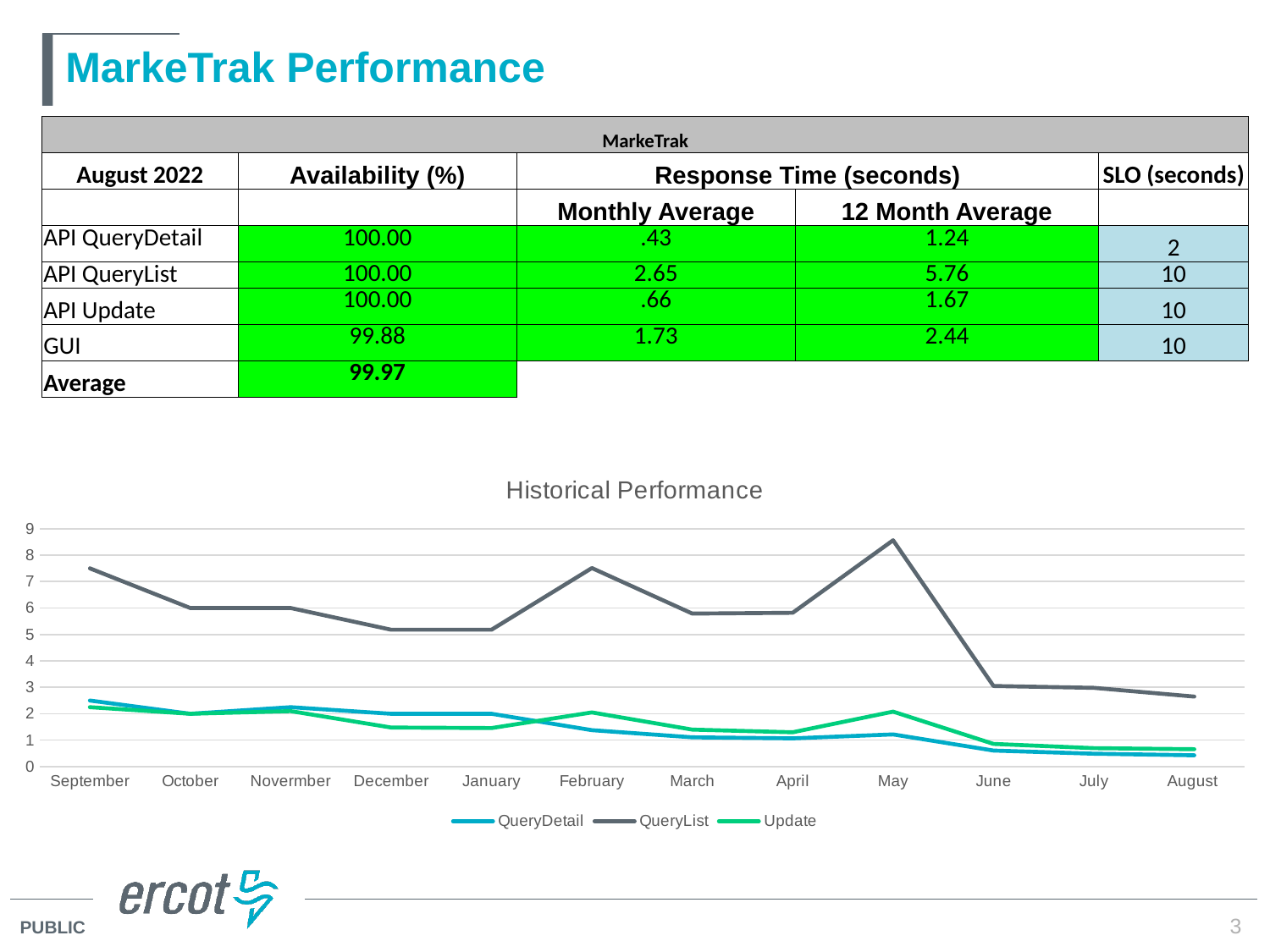
Does the QueryList series rise or fall between May and June on the Historical Performance chart? fall What is the title of the line chart on the slide? Historical Performance Which series has the larger value in May on the Historical Performance chart, QueryList or Update? QueryList Is the QueryList value for December greater or less than 6 on the Historical Performance chart? less In which month does the QueryList series reach its highest value on the Historical Performance chart? May Is the QueryDetail value for August greater or less than 1 on the Historical Performance chart? less How many series does the legend of the Historical Performance chart list? 3 How many months are plotted along the x axis of the Historical Performance chart? 12 What kind of chart is the Historical Performance chart? line chart Is the QueryList value for May greater or less than 8 on the Historical Performance chart? greater Which series is drawn in dark grey on the Historical Performance chart? QueryList